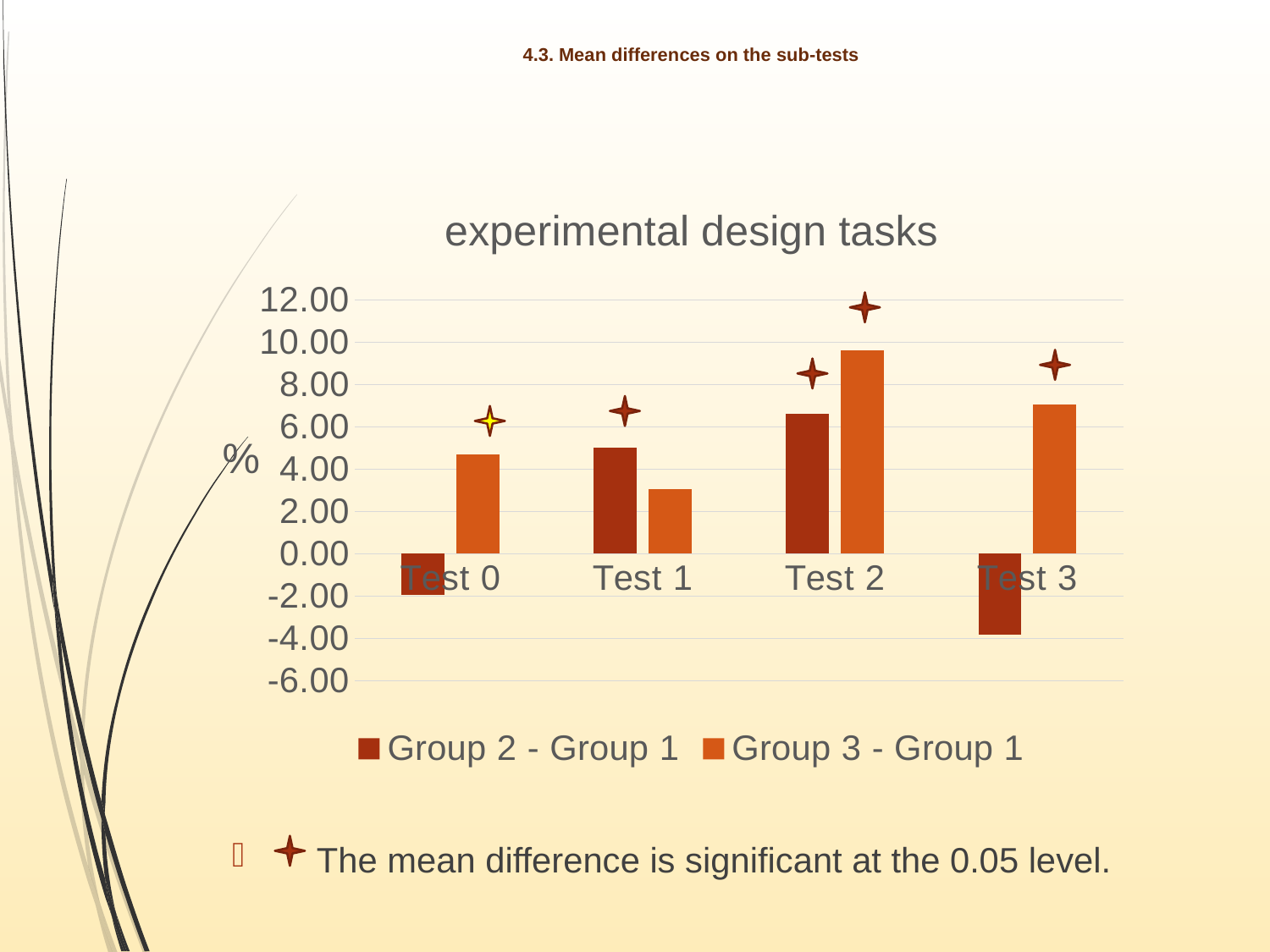
What label is shown on the vertical axis of the chart? % For which test is the Group 2 - Group 1 value highest? Test 2 For which test is the Group 3 - Group 1 value lowest? Test 1 What is the title of the chart? experimental design tasks How many series does the chart's legend list? 2 What kind of chart is shown on the slide? bar chart Is the Group 3 - Group 1 value for Test 2 greater or less than 8.00? greater At Test 1, which series has the larger value, Group 2 - Group 1 or Group 3 - Group 1? Group 2 - Group 1 For which test is the Group 3 - Group 1 value highest? Test 2 For which test is the Group 2 - Group 1 value lowest? Test 3 Is the Group 2 - Group 1 value for Test 3 greater or less than 0.00? less How many test categories are shown on the x axis of the chart? 4